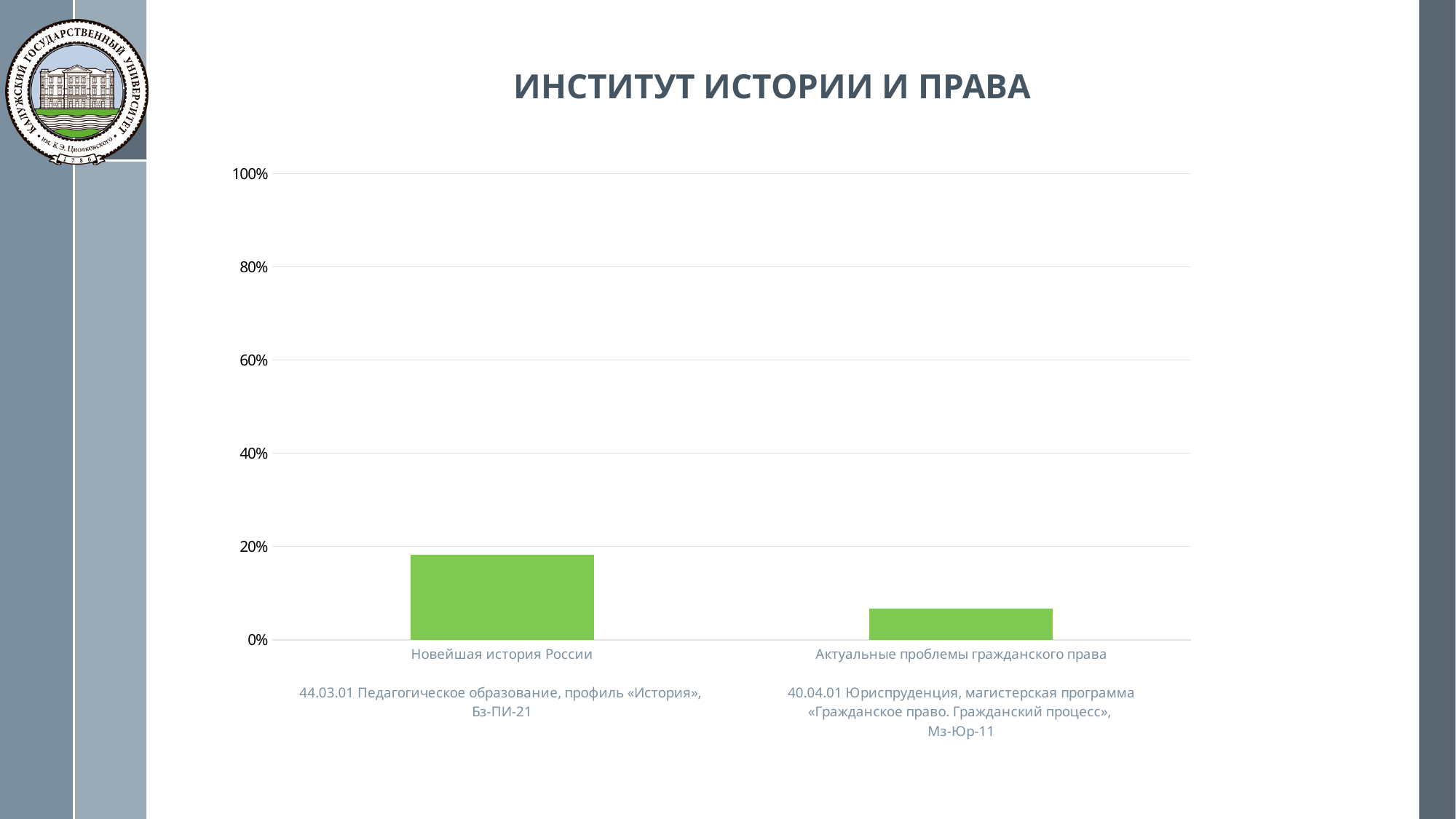
What kind of chart is shown on the slide? bar chart Which category has the lowest value? Актуальные проблемы гражданского права Is the value for Новейшая история России greater or less than 20%? less Which is larger: the value for Новейшая история России or the value for Актуальные проблемы гражданского права? Новейшая история России Do the values rise or fall from left to right along the x axis? fall What is the title of the slide above the chart? ИНСТИТУТ ИСТОРИИ И ПРАВА Is the value for Актуальные проблемы гражданского права greater or less than 20%? less What is the highest value shown on the vertical axis? 100% Is the value for Актуальные проблемы гражданского права greater or less than 0%? greater How many bars (categories) does the chart show? 2 Which category has the highest value? Новейшая история России